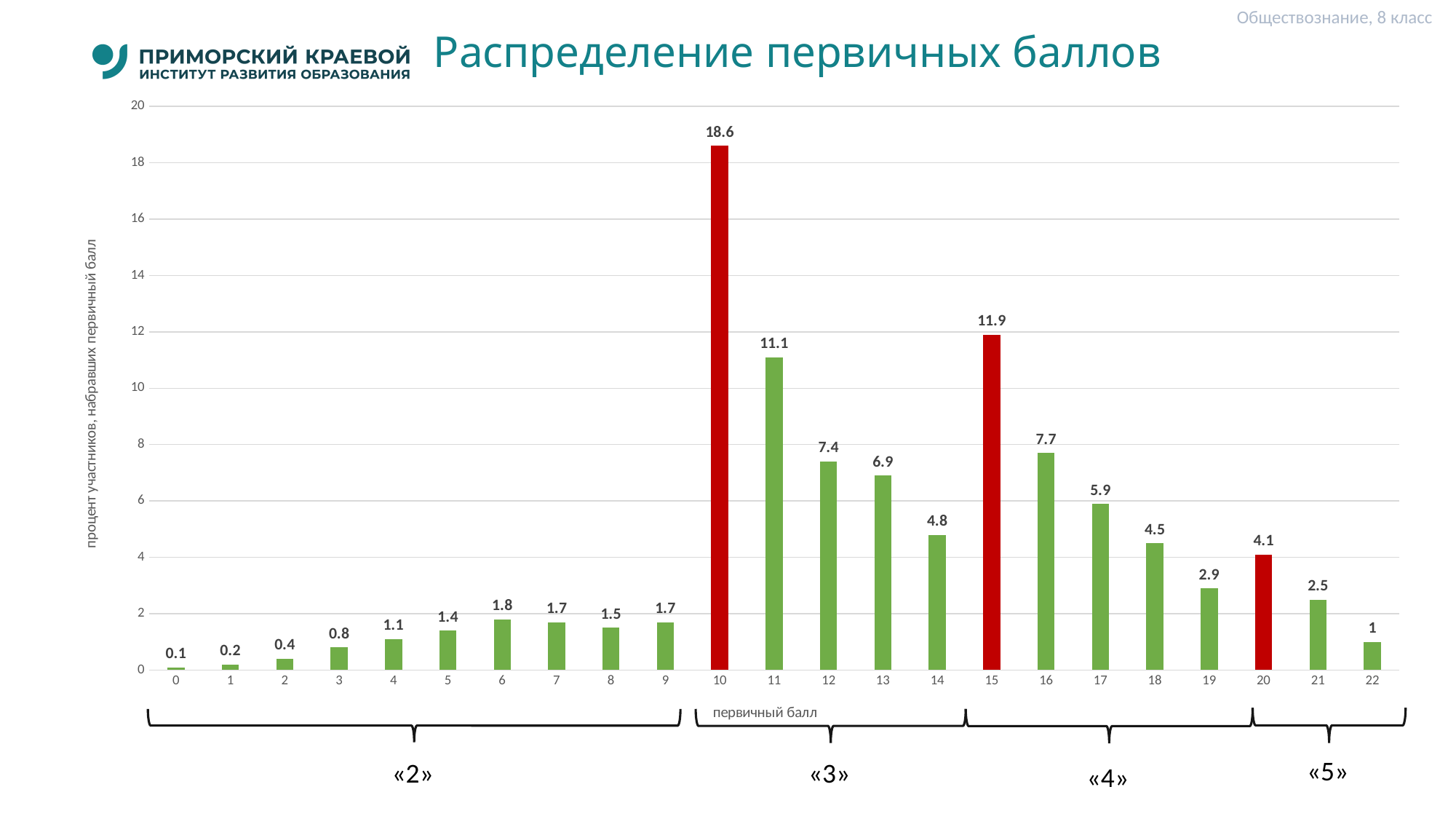
What percentage of participants scored 15 primary points? 11.9 What is the value for primary score 22? 1 What kind of chart is shown on the slide? bar chart What is the difference between the values for primary scores 10 and 15? 6.7 Which is larger, the value for primary score 11 or for primary score 15? 15 Is the value for primary score 16 greater or less than 6? greater How many primary score categories are shown on the x axis? 23 Which primary score has the highest percentage of participants? 10 Which primary score has the lowest percentage of participants? 0 Do the values rise or fall from primary score 15 to primary score 19? fall Which primary scores are shown with red bars? 10, 15, 20 What is the value for primary score 10? 18.6